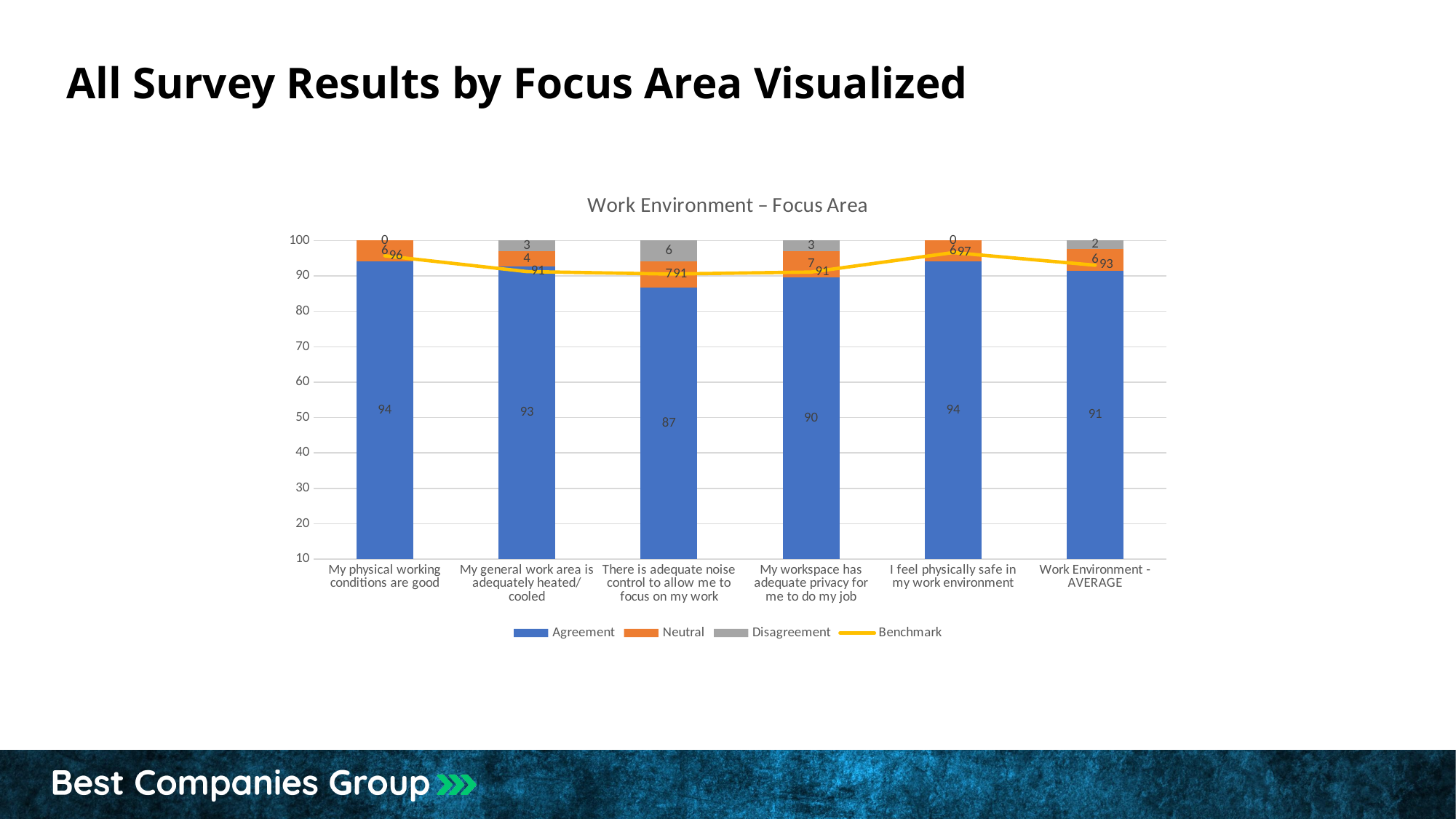
What is the difference between the Agreement value for "My physical working conditions are good" and for "There is adequate noise control to allow me to focus on my work"? 7 What is the Agreement value for "There is adequate noise control to allow me to focus on my work"? 87 How many categories are shown on the x axis? 6 How many series does the legend list? 4 What is the Benchmark value for "I feel physically safe in my work environment"? 97 What is the Agreement value for "Work Environment - AVERAGE"? 91 What is the title of the chart? Work Environment – Focus Area What is the Neutral value for "My workspace has adequate privacy for me to do my job"? 7 What kind of chart is shown on the slide? Stacked bar chart with a line Which category has the highest Benchmark value? I feel physically safe in my work environment Which has a higher Agreement value: "My general work area is adequately heated/cooled" or "My workspace has adequate privacy for me to do my job"? My general work area is adequately heated/cooled Which category has the lowest Agreement value? There is adequate noise control to allow me to focus on my work